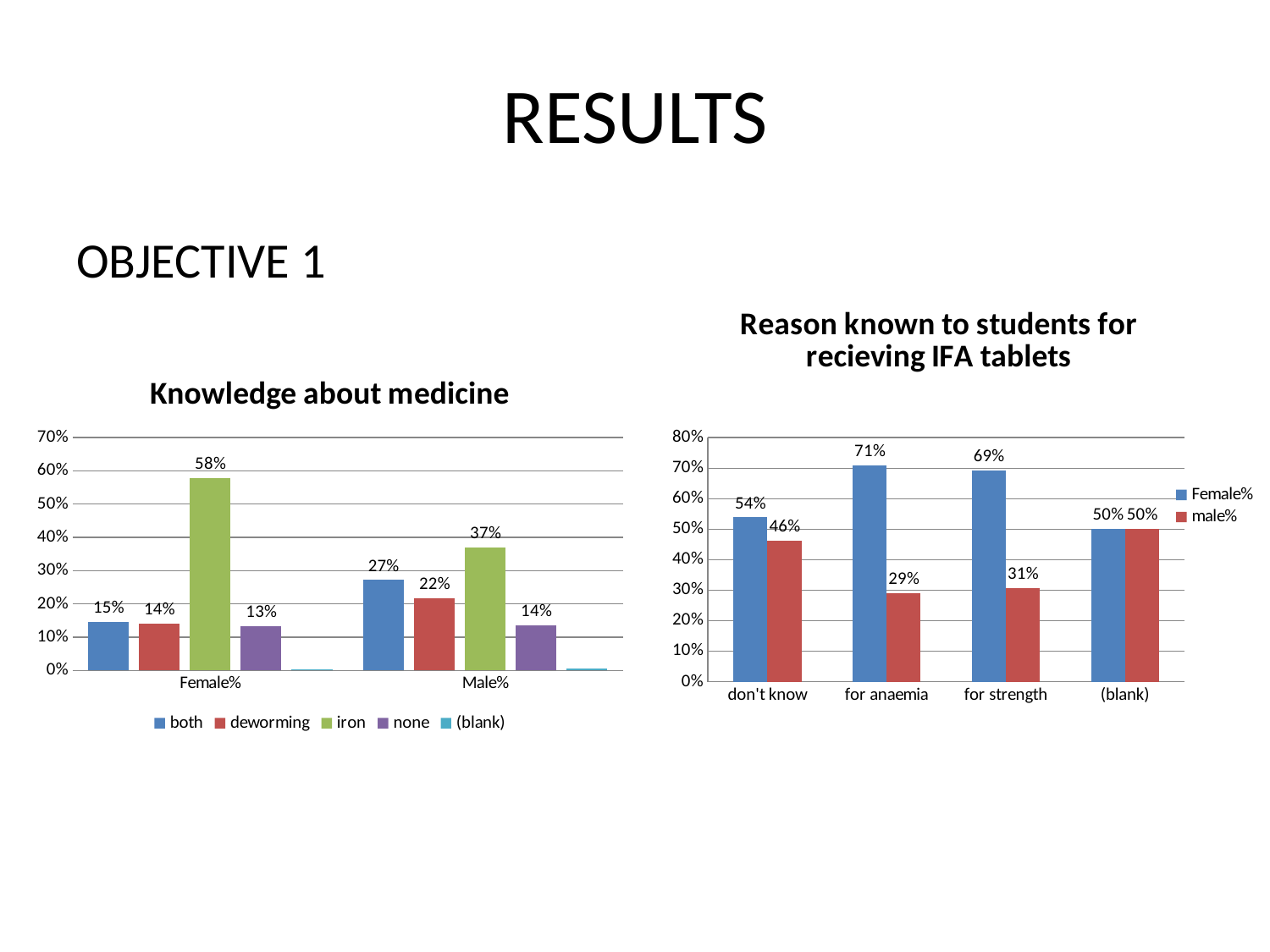
In the 'Knowledge about medicine' chart, what is the value for iron in the Female% group? 58% In the 'Knowledge about medicine' chart, what is the difference between the iron values for Female% and Male%? 21% In the 'Knowledge about medicine' chart, which series has the highest value in the Male% group? iron In the 'Knowledge about medicine' chart, is the deworming value for Male% greater or less than 20%? greater In the 'Reason known to students for recieving IFA tablets' chart, what is the difference between the Female% and male% values for 'don't know'? 8% In the 'Reason known to students for recieving IFA tablets' chart, what is the Female% value for 'for anaemia'? 71% What kind of chart is the 'Reason known to students for recieving IFA tablets' chart? bar chart In the 'Knowledge about medicine' chart, how many series does the legend list? 5 In the 'Reason known to students for recieving IFA tablets' chart, how many categories are shown on the x axis? 4 In the 'Knowledge about medicine' chart, what is the value for both in the Male% group? 27% In the 'Reason known to students for recieving IFA tablets' chart, which category has the lowest male% value? for anaemia In the 'Reason known to students for recieving IFA tablets' chart, what is the male% value for 'for strength'? 31%